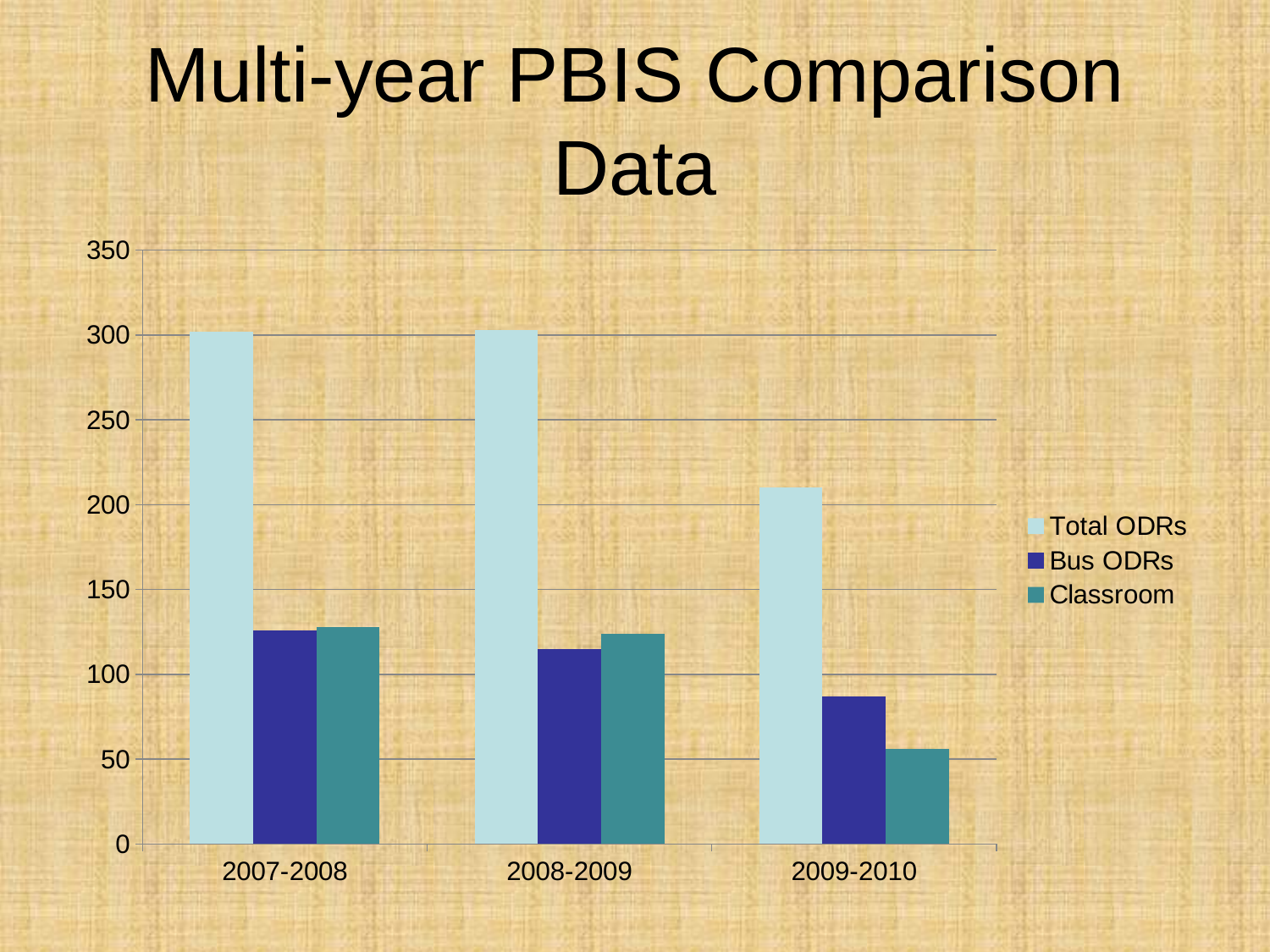
How many series does the legend list? 3 In 2009-2010, which is larger, Bus ODRs or Classroom? Bus ODRs Do the Bus ODRs values rise or fall from 2007-2008 to 2009-2010? fall What kind of chart is shown on the slide? bar chart Is the Bus ODRs value for 2008-2009 greater or less than 100? greater Which school year has the lowest Classroom value? 2009-2010 Is the Bus ODRs value for 2009-2010 greater or less than 100? less Which school year has the lowest Total ODRs? 2009-2010 What is the title of the chart? Multi-year PBIS Comparison Data How many school-year categories are shown on the x axis? 3 Is the Total ODRs value for 2007-2008 greater or less than 250? greater